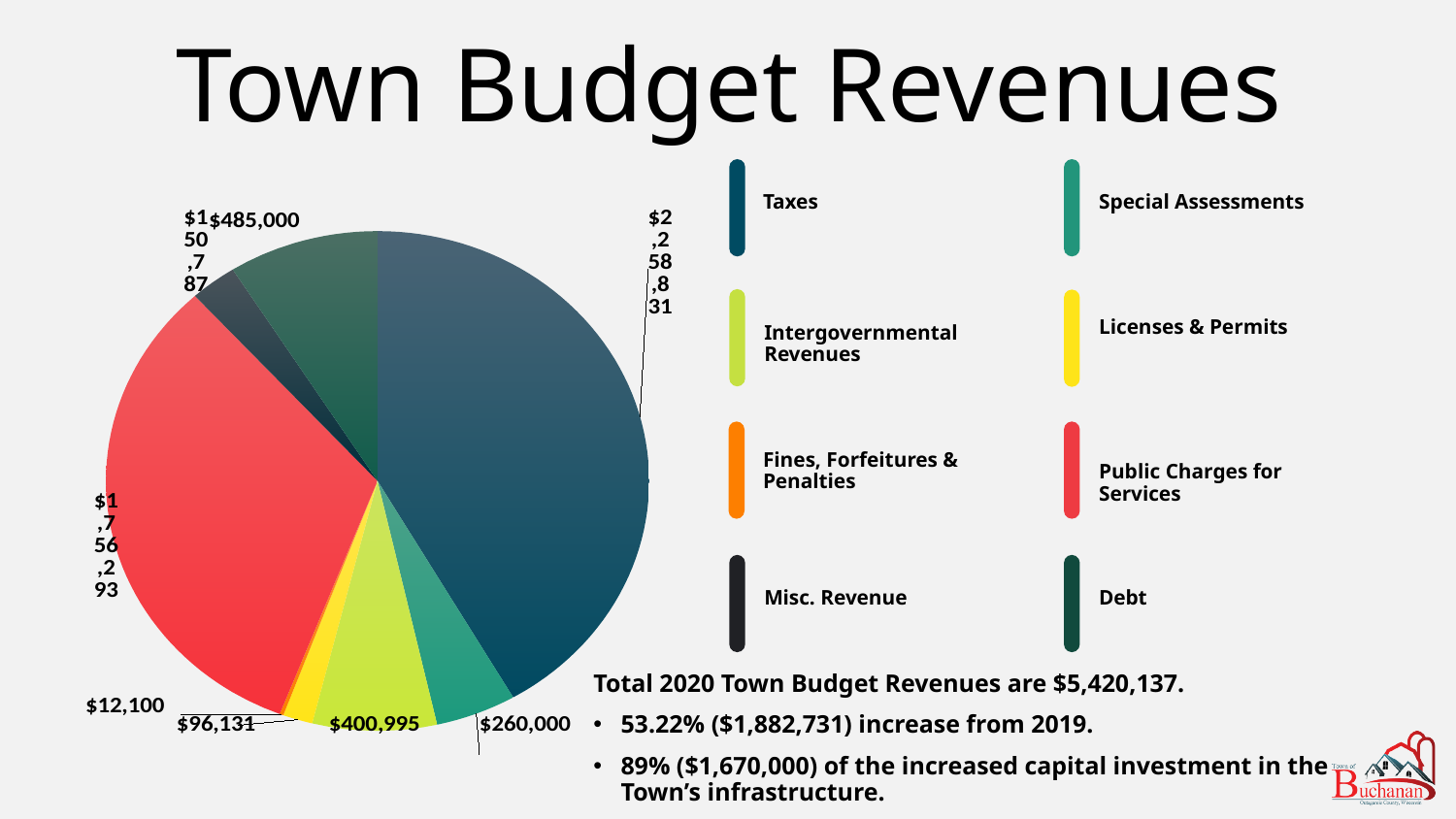
What is the value of the Intergovernmental Revenues slice? $400,995 What is the value of the Special Assessments slice? $260,000 Which category has the largest slice of the pie? Taxes What is the difference between the Debt value and the Special Assessments value? $225,000 Which category has the smallest slice of the pie? Fines, Forfeitures & Penalties How many categories does the legend of the pie chart list? 8 Which is larger, the Public Charges for Services slice or the Taxes slice? Taxes What is the value of the Debt slice? $485,000 What is the value of the Taxes slice? $2,258,831 What is the value of the Licenses & Permits slice? $96,131 What kind of chart is shown on the slide? pie chart What colour is the Public Charges for Services slice in the legend? red